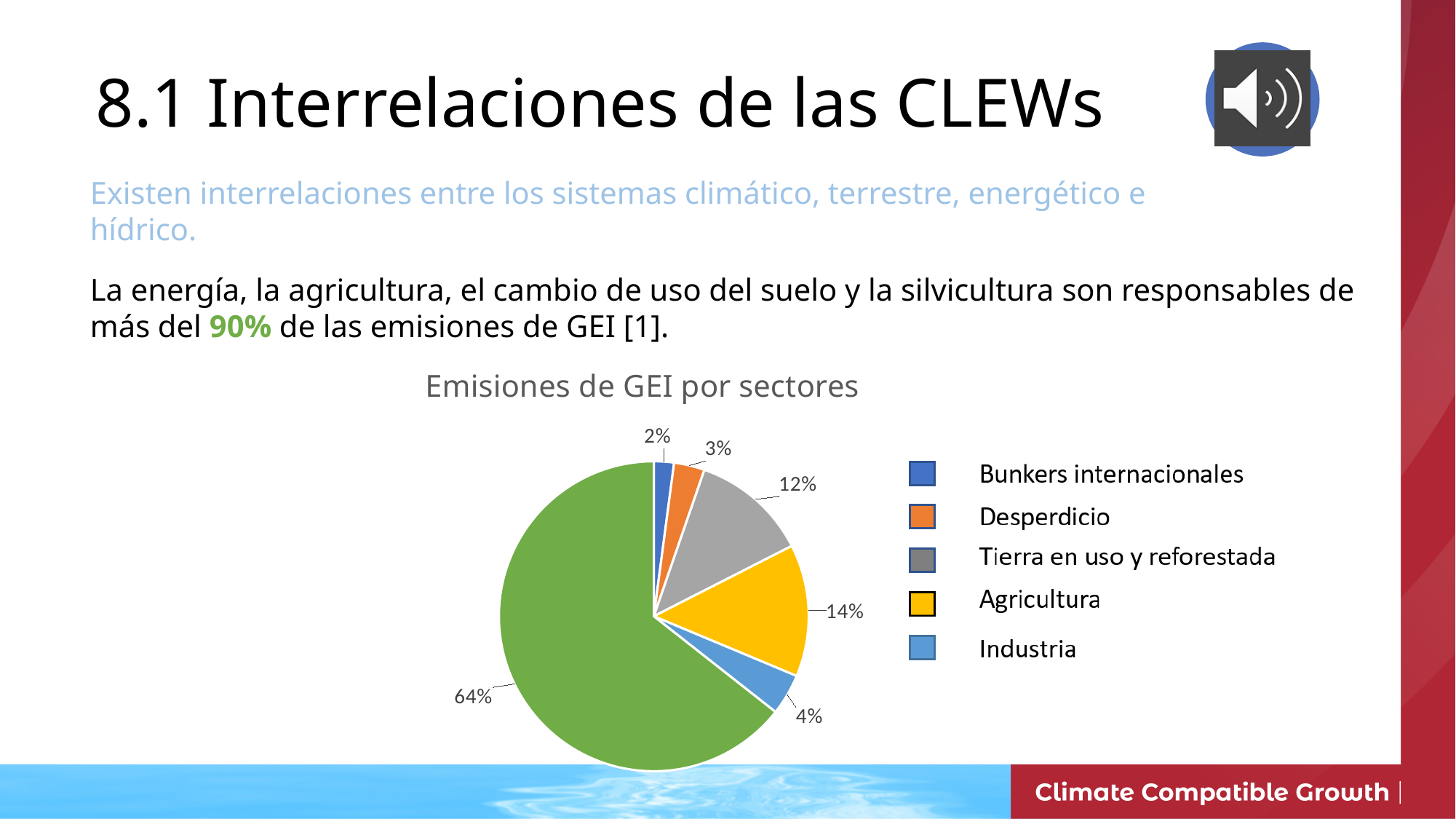
How many entries does the legend list? 5 How many slices does the pie chart have? 6 What type of chart is shown on the slide? Pie chart What percentage is shown for Tierra en uso y reforestada? 12% What share of the pie does Agricultura represent? 14% Which slice is larger, Industria or Desperdicio? Industria Which of the categories listed in the legend has the smallest slice? Bunkers internacionales What share of the pie does Industria account for? 4% What is the largest percentage labelled on the pie chart? 64% What percentage is shown for Bunkers internacionales? 2% How many percentage points larger is the Agricultura slice than the Tierra en uso y reforestada slice? 2% What percentage is shown for Desperdicio? 3%